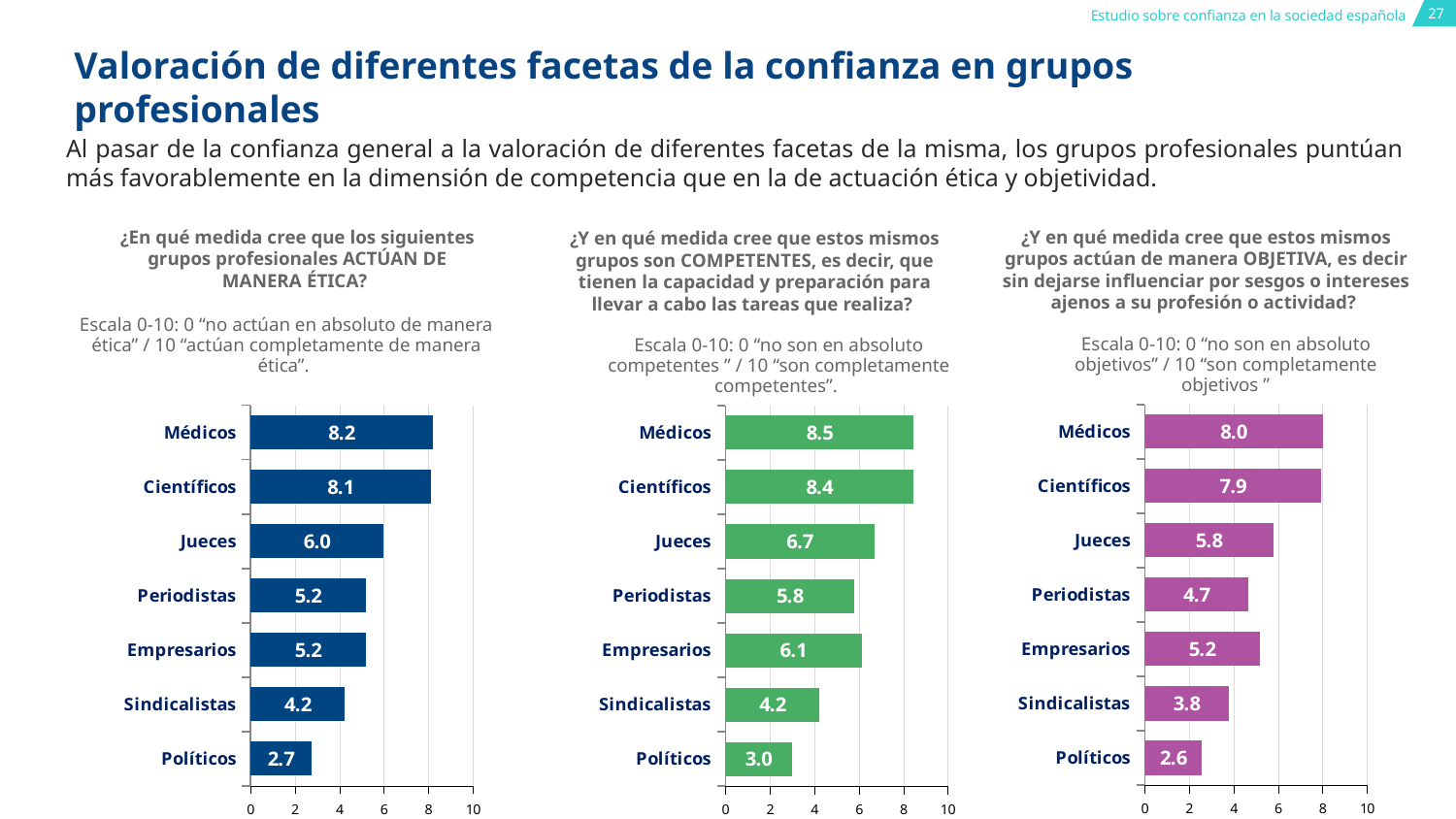
In the middle chart (son competentes), what is the value for Empresarios? 6.1 What colour are the bars in the right chart (actúan de manera objetiva)? purple In the left chart (actúan de manera ética), what is the value for Jueces? 6.0 In the middle chart (son competentes), which group has the highest value? Médicos What type of chart is the middle chart (son competentes)? bar chart In the middle chart (son competentes), which is larger, the value for Periodistas or the value for Empresarios? Empresarios How many professional groups are shown in the left chart (actúan de manera ética)? 7 In the right chart (actúan de manera objetiva), what is the difference between the values for Jueces and Empresarios? 0.6 In the right chart (actúan de manera objetiva), what is the value for Periodistas? 4.7 In the right chart (actúan de manera objetiva), which group has the lowest value? Políticos In the left chart (actúan de manera ética), what is the difference between the values for Médicos and Políticos? 5.5 In the right chart (actúan de manera objetiva), is the value for Sindicalistas greater or less than 4? less